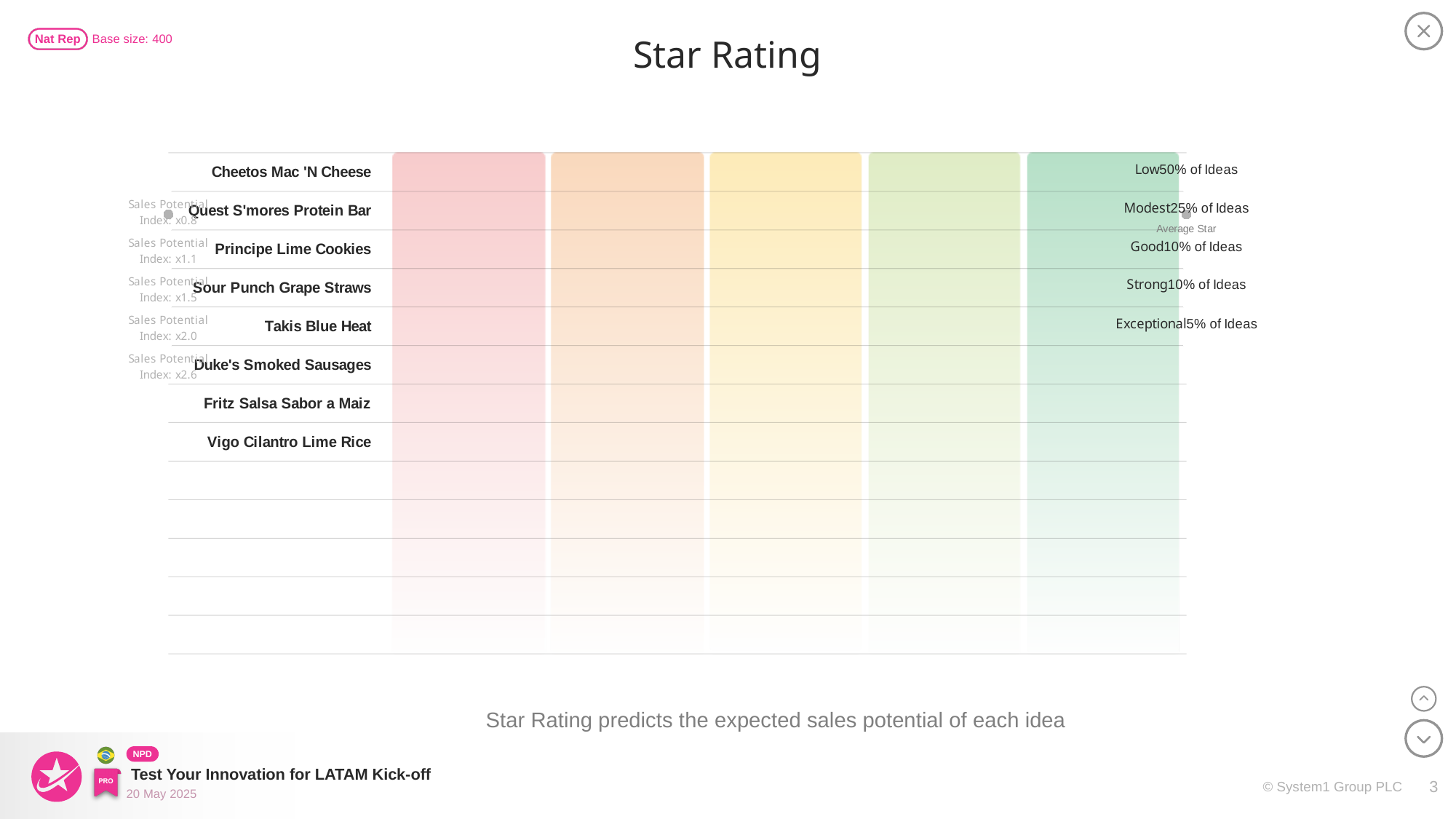
How many rating bands (Low to Exceptional) does the Star Rating chart show? 5 Which band has a larger share of ideas on the Star Rating chart, Low or Modest? Low According to the Star Rating chart, what percentage of ideas fall in the Exceptional band? 5% of Ideas What is the difference between the share of ideas in the Low band and the Modest band on the Star Rating chart? 25% What is the title of the chart on the slide? Star Rating According to the Star Rating chart, what percentage of ideas fall in the Modest band? 25% of Ideas Which product idea is listed first on the Star Rating chart? Cheetos Mac 'N Cheese According to the Star Rating chart, what percentage of ideas fall in the Low band? 50% of Ideas How many product ideas are listed on the Star Rating chart? 8 What base size is shown on the slide? 400